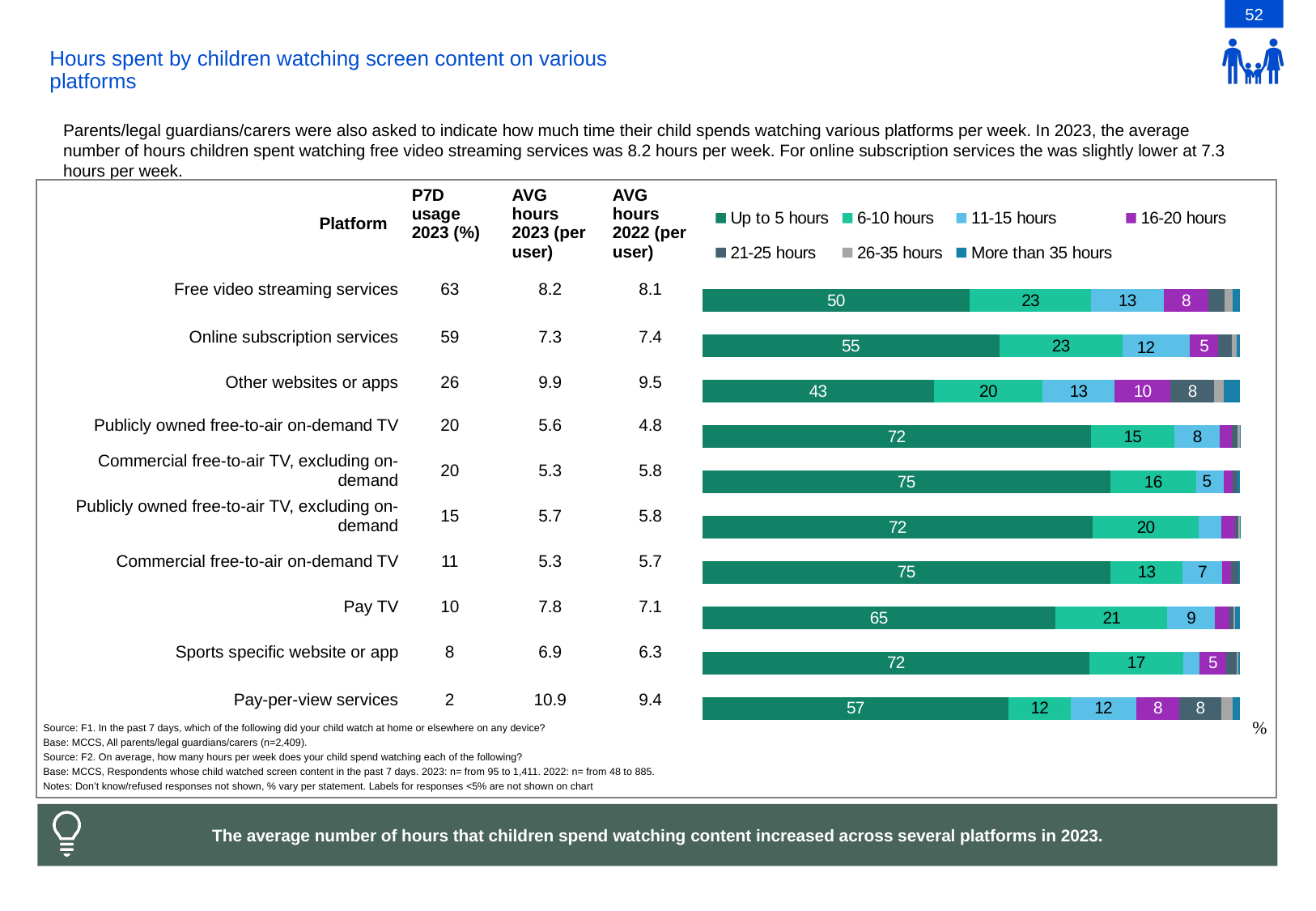
How many series does the chart legend list? 7 What kind of chart is shown on the slide? Stacked bar chart What percentage of children watching free video streaming services spend up to 5 hours per week on it? 50 What is the value of the 16-20 hours segment for other websites or apps? 10 What is the value of the 6-10 hours segment for online subscription services? 23 What is the value of the 6-10 hours segment for Pay TV? 21 How many platforms are plotted in the chart? 10 Which series in the legend is shown in purple? 16-20 hours What is the difference between the up to 5 hours values for free video streaming services and other websites or apps? 7 What is the value of the up to 5 hours segment for pay-per-view services? 57 Which platform has the lowest value for the up to 5 hours segment? Other websites or apps Which has a larger up to 5 hours value: Pay TV or pay-per-view services? Pay TV